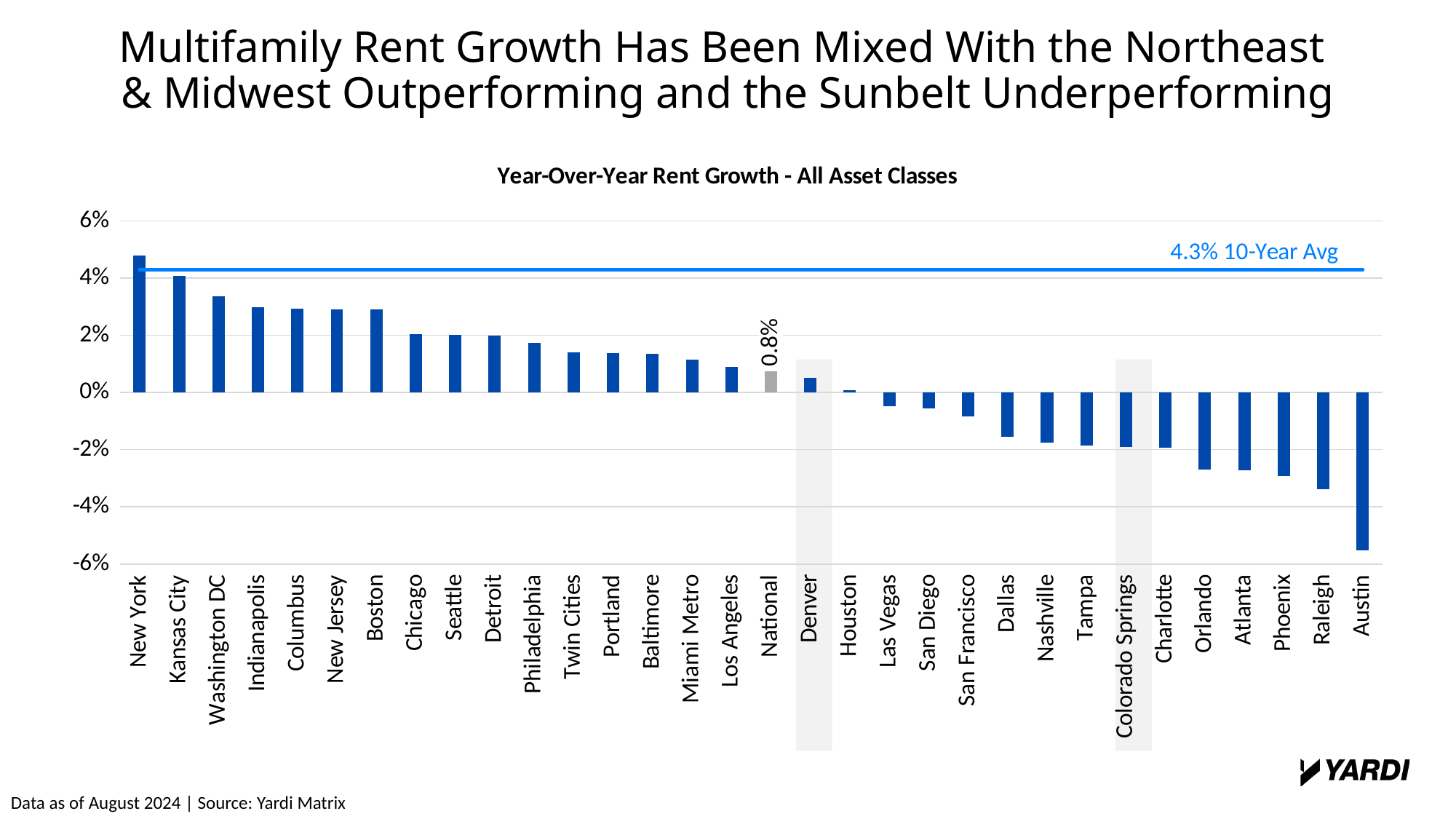
Is the value for Washington DC greater or less than 2%? greater How many metros (including National) are shown on the x axis? 32 What type of chart is shown on the slide? bar chart What value does the horizontal reference line labelled as the 10-Year Avg represent? 4.3% Which has the higher rent growth, Kansas City or Boston? Kansas City Which metro has the lowest year-over-year rent growth? Austin Which metro has the highest year-over-year rent growth? New York Do the bar values generally rise or fall moving from left to right along the x axis? fall What is the title of the chart? Year-Over-Year Rent Growth - All Asset Classes What is the year-over-year rent growth value shown for National? 0.8% Is the value for Austin greater or less than -4%? less Is the value for New York greater or less than 4%? greater